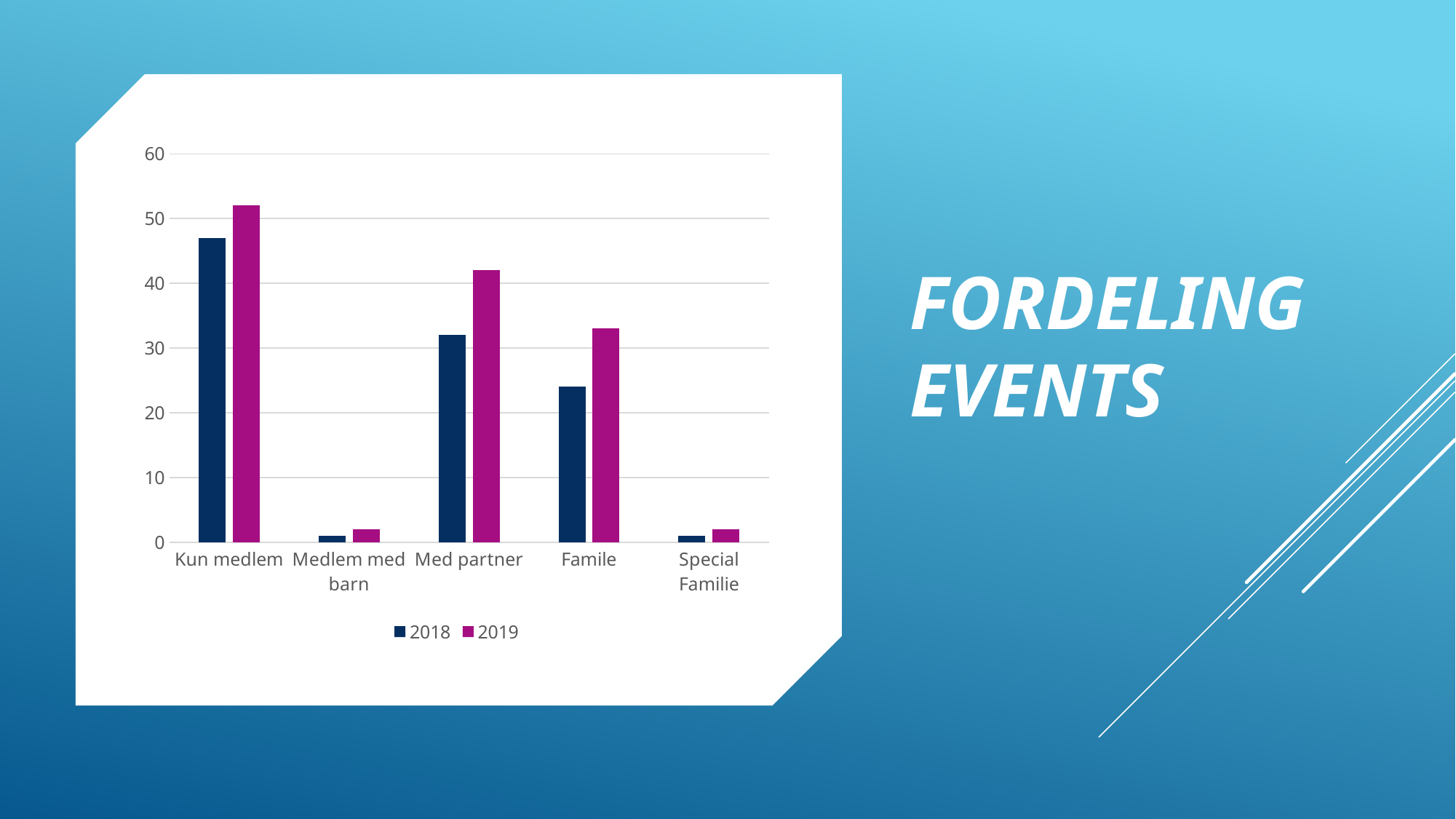
Is the value for Kun medlem in 2019 greater or less than 50? greater Which is larger: the 2019 value for Famile or the 2019 value for Med partner? Med partner What are the two series listed in the chart's legend? 2018 and 2019 Which category has the highest value for 2019? Kun medlem What kind of chart is shown on the slide? bar chart How many categories are shown on the x axis of the chart? 5 How many series does the chart's legend list? 2 Which category has the highest value for 2018? Kun medlem Is the value for Kun medlem in 2018 greater or less than 50? less Is the value for Famile in 2018 greater or less than 30? less Which is larger for Med partner: the 2018 value or the 2019 value? 2019